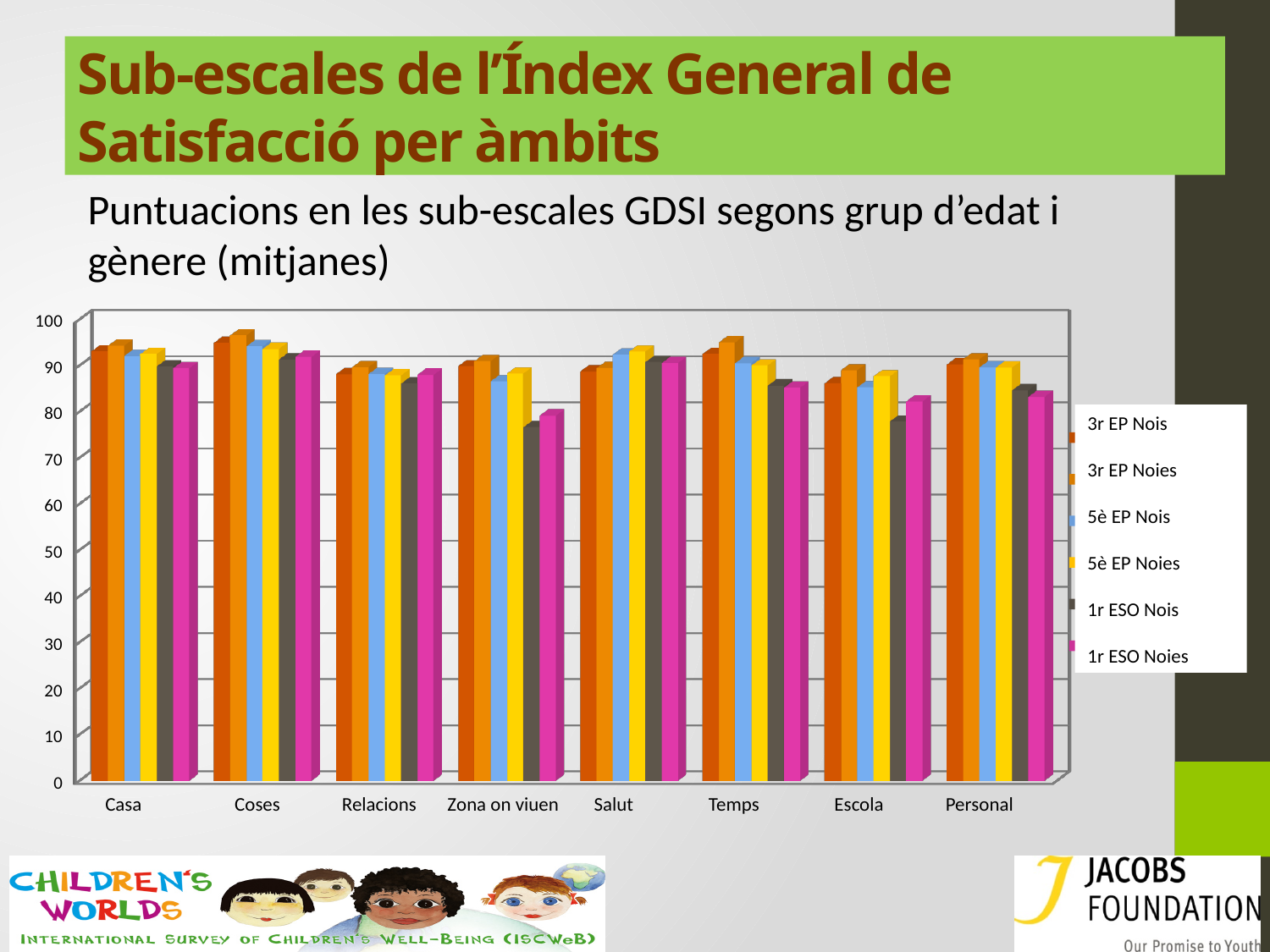
Is the value for 1r ESO Nois in the Temps category greater or less than 90? less Is the value for 3r EP Noies in the Coses category greater or less than 90? greater For the 3r EP Noies series, which is larger: the value for Coses or the value for Escola? Coses How many series does the chart's legend list? 6 Is the value for 3r EP Nois in the Casa category greater or less than 90? greater In the Zona on viuen category, which is larger: the value for 1r ESO Nois or for 1r ESO Noies? 1r ESO Noies What kind of chart is shown on the slide? bar chart Which series is listed first in the chart's legend? 3r EP Nois How many categories are shown along the x axis of the chart? 8